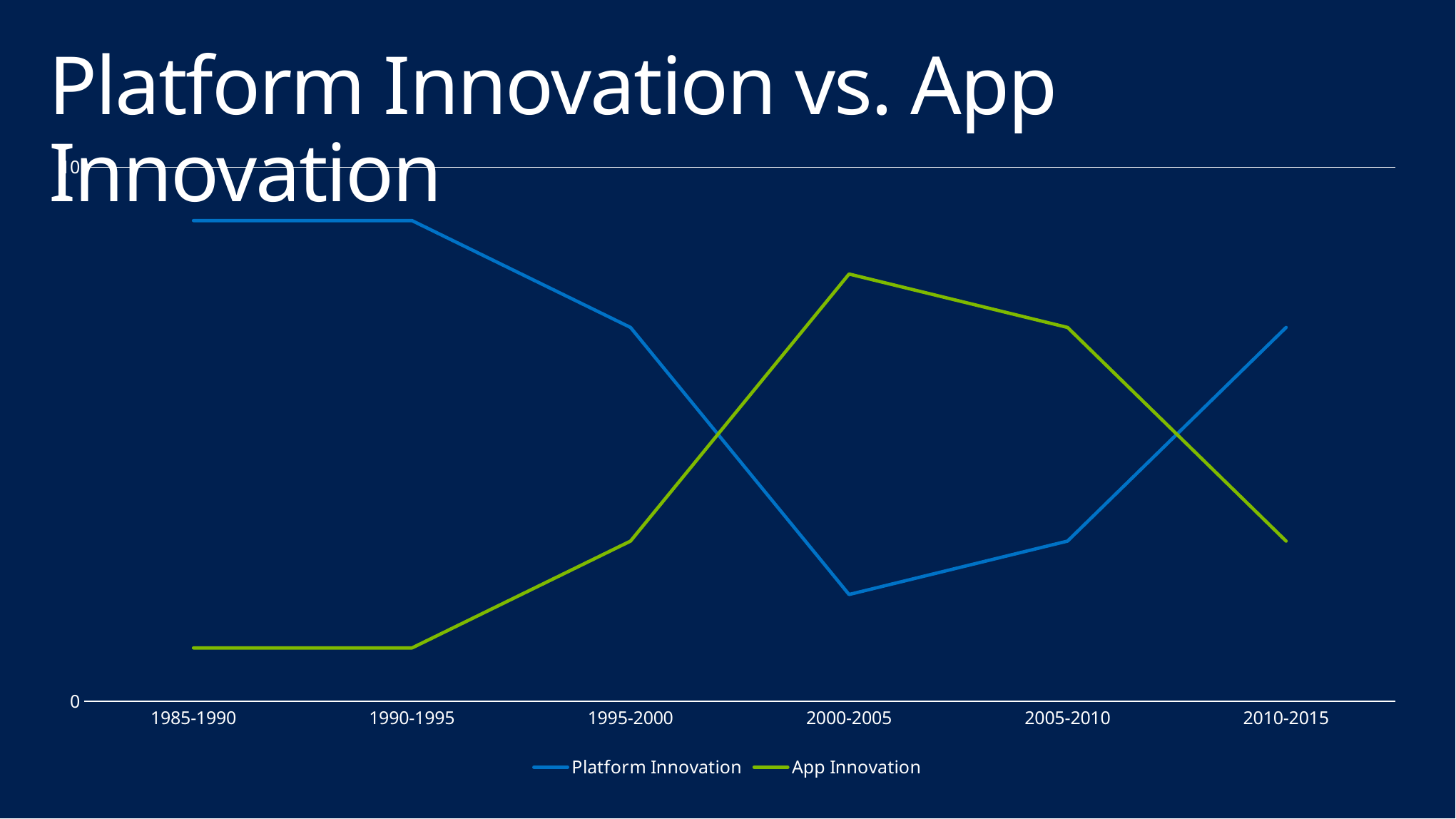
How many series does the legend list? 2 Does Platform Innovation rise or fall from 2000-2005 to 2010-2015? Rise What kind of chart is shown on the slide? Line chart In 2005-2010, which is higher: Platform Innovation or App Innovation? App Innovation What is the title of the slide? Platform Innovation vs. App Innovation In 2010-2015, which is higher: Platform Innovation or App Innovation? Platform Innovation Does App Innovation rise or fall from 2000-2005 to 2010-2015? Fall In 1995-2000, which is higher: Platform Innovation or App Innovation? Platform Innovation In which period is App Innovation at its highest? 2000-2005 In which period is Platform Innovation at its lowest? 2000-2005 How many time periods are shown on the x axis? 6 What colour is the App Innovation line? Green